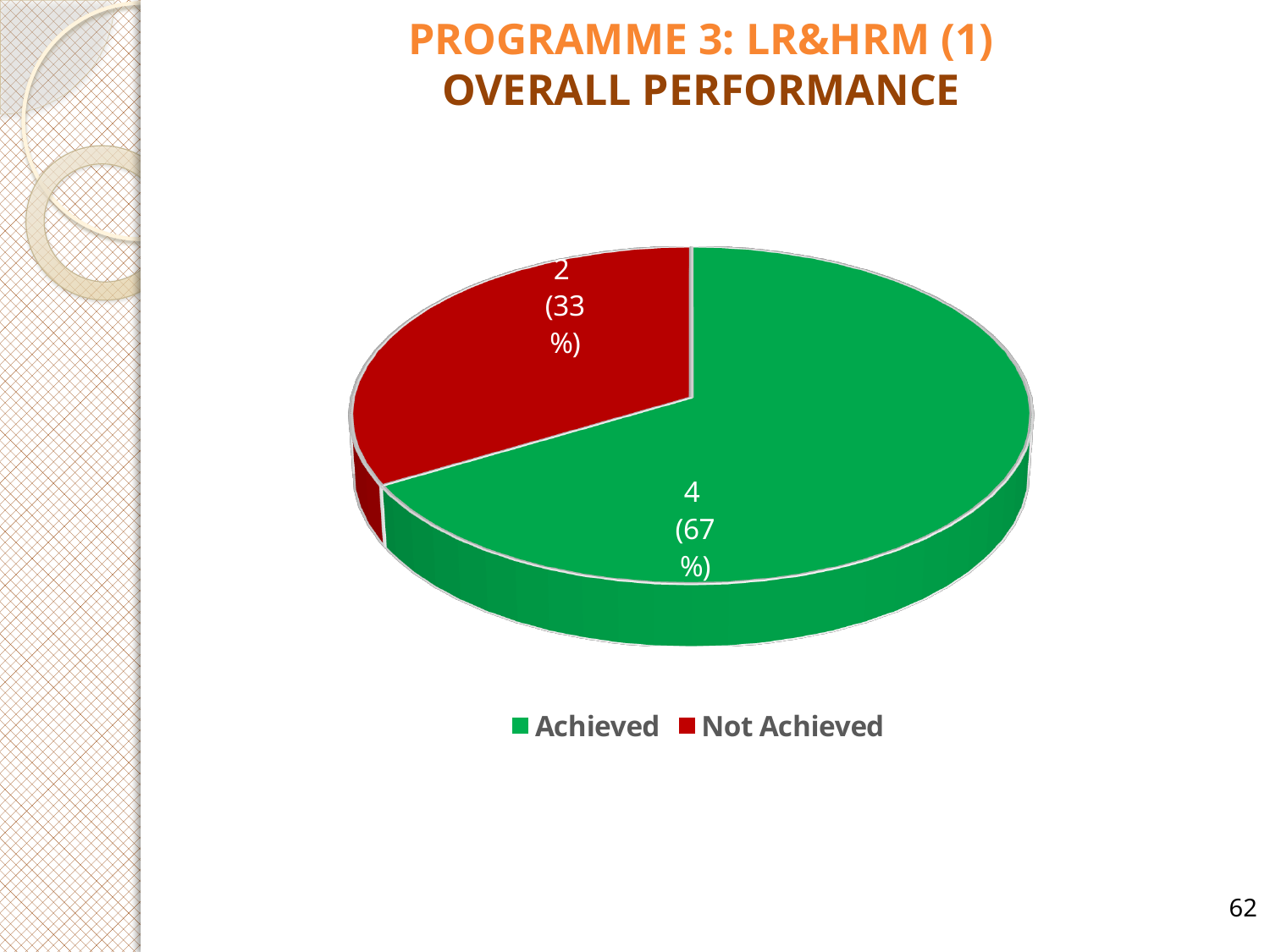
Which category has the smallest slice of the pie? Not Achieved Which category has the largest slice of the pie? Achieved What colour represents Not Achieved in the legend? red What percentage share of the pie is Achieved? 67% What kind of chart is shown on the slide? pie chart What is the total of the two slices in the pie chart? 6 How many categories does the pie chart have? 2 How many indicators were Not Achieved? 2 How many indicators were Achieved? 4 What is the difference between the number Achieved and the number Not Achieved? 2 Which is larger, Achieved or Not Achieved? Achieved What percentage share of the pie is Not Achieved? 33%